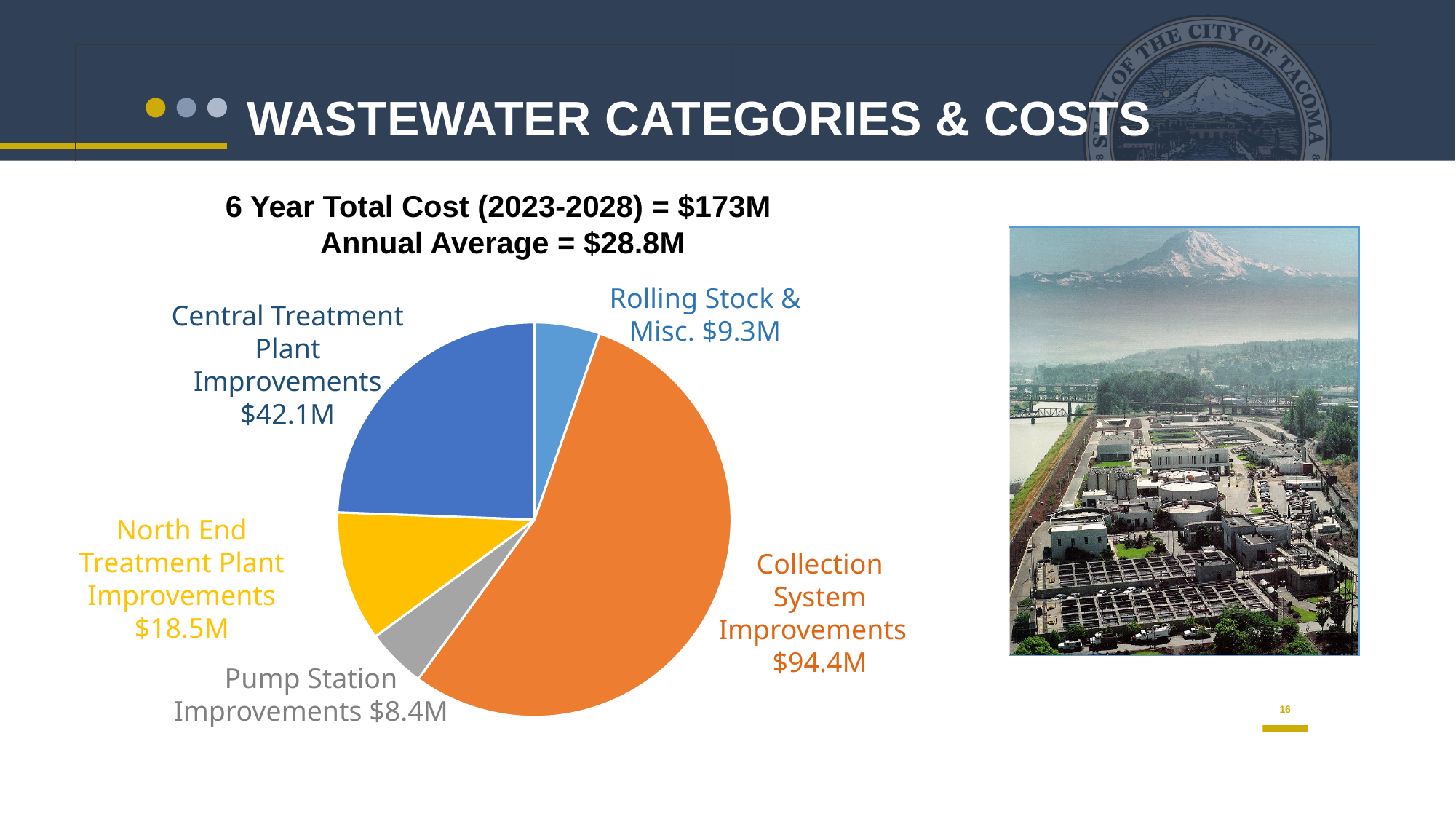
What is the value for Pump Station Improvements? $8.4M Which category has the largest cost in the pie chart? Collection System Improvements What is the value for North End Treatment Plant Improvements? $18.5M What is the value for Collection System Improvements? $94.4M What is the value for Central Treatment Plant Improvements? $42.1M What is the 6 year total cost (2023-2028) stated above the chart? $173M What is the difference between Collection System Improvements and Central Treatment Plant Improvements? $52.3M Which category has the smallest cost in the pie chart? Pump Station Improvements What type of chart is shown on the slide? Pie chart Which is larger, Rolling Stock & Misc. or Pump Station Improvements? Rolling Stock & Misc. What is the value for Rolling Stock & Misc.? $9.3M How many categories (slices) does the pie chart have? 5